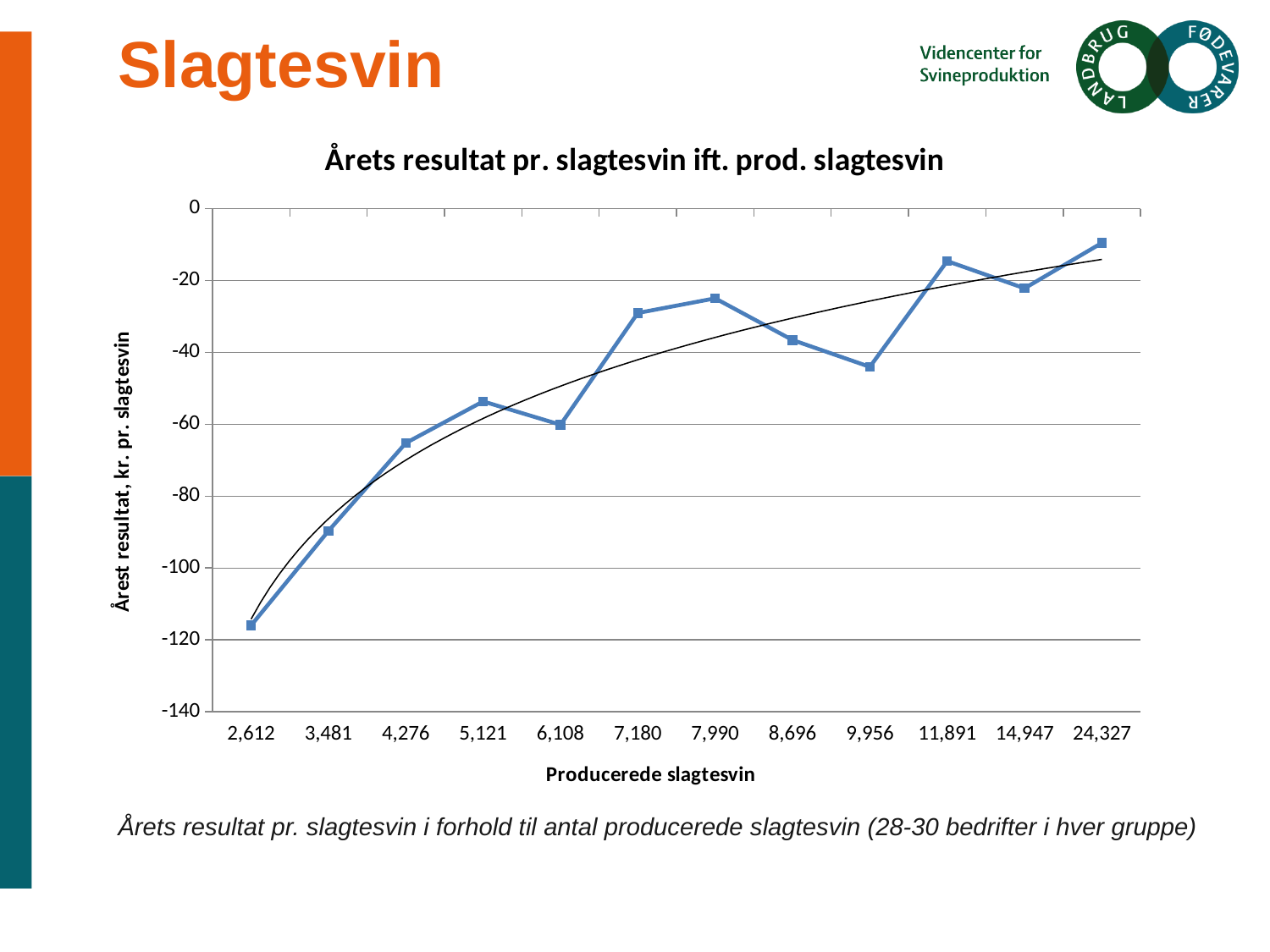
Is the value for 11,891 greater or less than -20? greater Is the value for 9,956 greater or less than -40? less How many categories are shown on the x axis of the chart? 12 Is the value for 2,612 greater or less than -100? less What kind of chart is shown on the slide? line chart Do the values generally rise or fall as the number of produced slaughter pigs increases along the x axis? rise Which category has the highest value in the chart? 24,327 What is the title of the chart? Årets resultat pr. slagtesvin ift. prod. slagtesvin Which has the larger value, 7,990 or 8,696? 7,990 Which category has the lowest value in the chart? 2,612